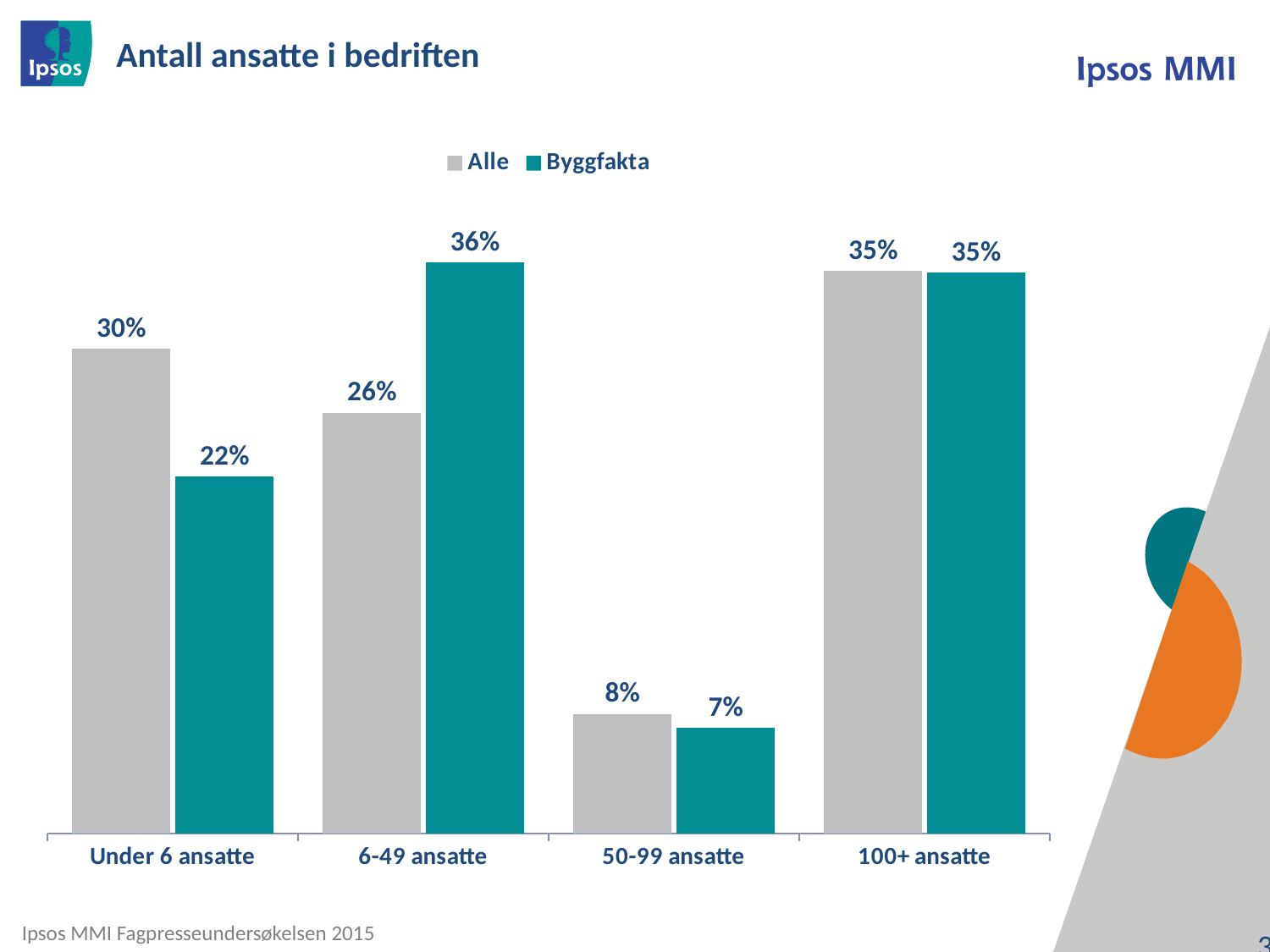
How many series does the legend list? 2 What is the difference between Alle and Byggfakta in the Under 6 ansatte category? 8% Which category has the lowest value for the Alle series? 50-99 ansatte What is the value for Byggfakta in the 50-99 ansatte category? 7% What is the difference between Byggfakta and Alle in the 6-49 ansatte category? 10% What is the value for Byggfakta in the 6-49 ansatte category? 36% Which is larger in the Under 6 ansatte category, Alle or Byggfakta? Alle How many categories are shown on the x axis? 4 Which category has the highest value for the Byggfakta series? 6-49 ansatte What kind of chart is shown on the slide? Bar chart What is the value for Alle in the 100+ ansatte category? 35% What is the value for Alle in the Under 6 ansatte category? 30%